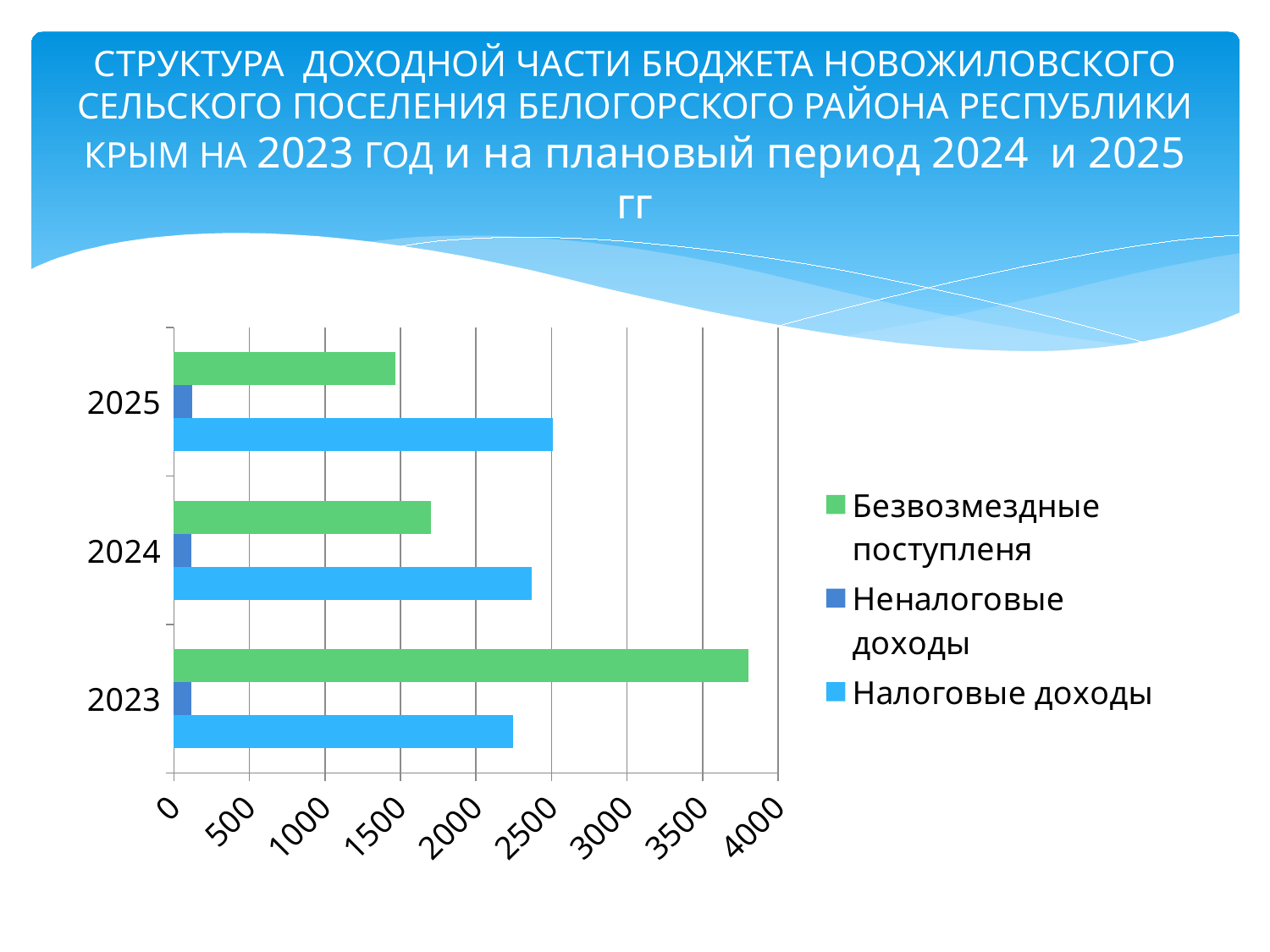
Do the values for Безвозмездные поступления rise or fall from 2023 to 2025? fall Is the value for Неналоговые доходы in 2023 greater or less than 500? less How many years (categories) are shown on the chart? 3 How many series does the chart legend list? 3 In 2025, which is larger: Налоговые доходы or Безвозмездные поступления? Налоговые доходы Is the value for Безвозмездные поступления in 2025 greater or less than 2000? less What kind of chart is shown on the slide? bar chart Which year has the highest value for Безвозмездные поступления? 2023 Is the value for Налоговые доходы in 2023 greater or less than 2000? greater Which year has the highest value for Налоговые доходы? 2025 In 2023, which is larger: Безвозмездные поступления or Налоговые доходы? Безвозмездные поступления